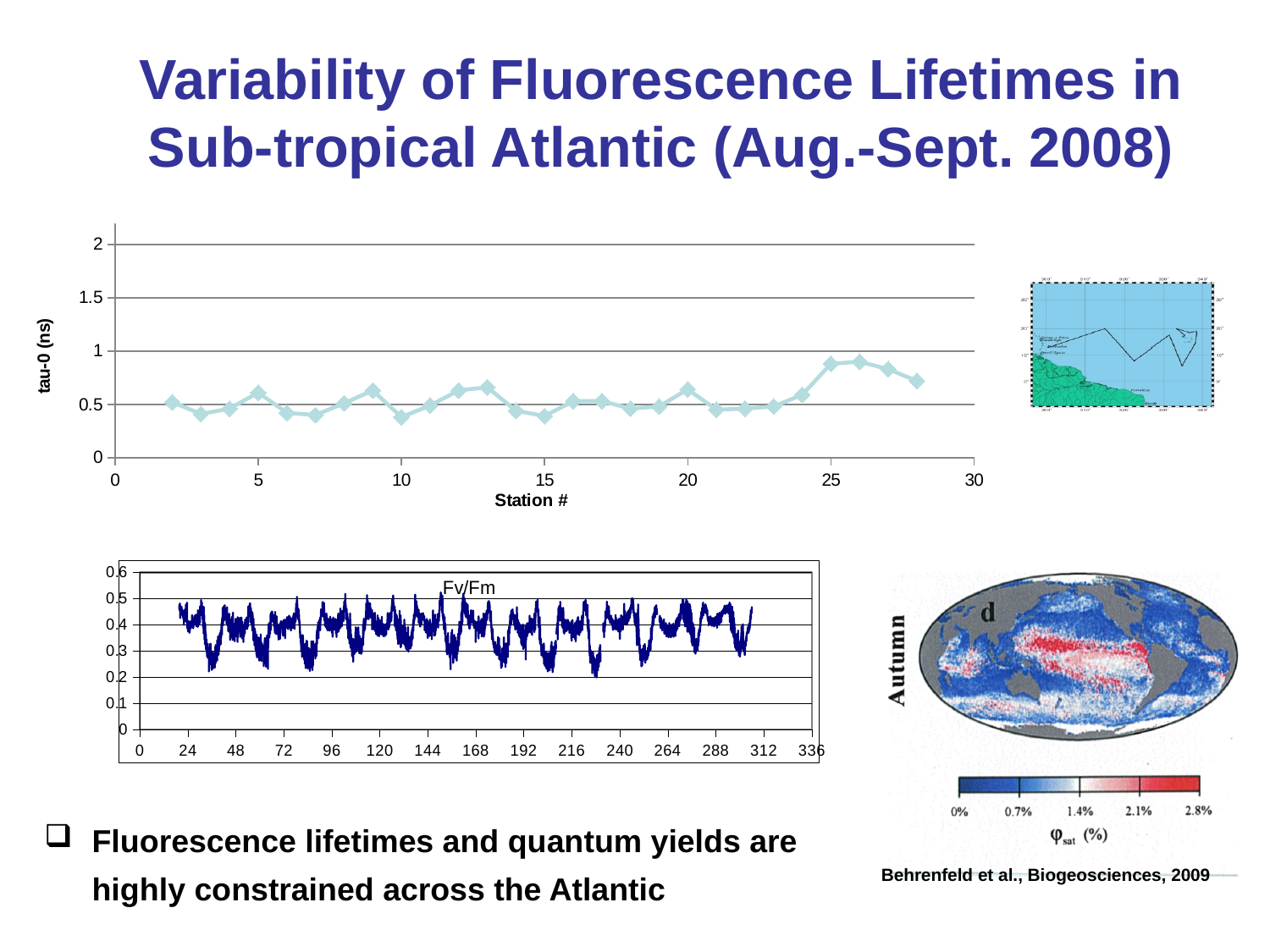
In the bottom chart, is the highest Fv/Fm value greater or less than 0.6? less In the top chart, is the tau-0 value at station 26 greater or less than 0.5? greater What is the y-axis label of the top chart? tau-0 (ns) In the top chart, do the tau-0 values rise or fall from station 26 to station 28? fall In the top chart, do the tau-0 values rise or fall from station 23 to station 26? rise In the top chart, is the tau-0 value at station 3 greater or less than 0.5? less In the top chart, is the tau-0 value at station 26 larger or smaller than the value at station 22? larger How many data series are plotted in the top chart? 1 What is the x-axis label of the top chart? Station # What kind of chart is the top chart (tau-0 vs Station #)? line chart What kind of chart is the bottom chart labelled Fv/Fm? line chart